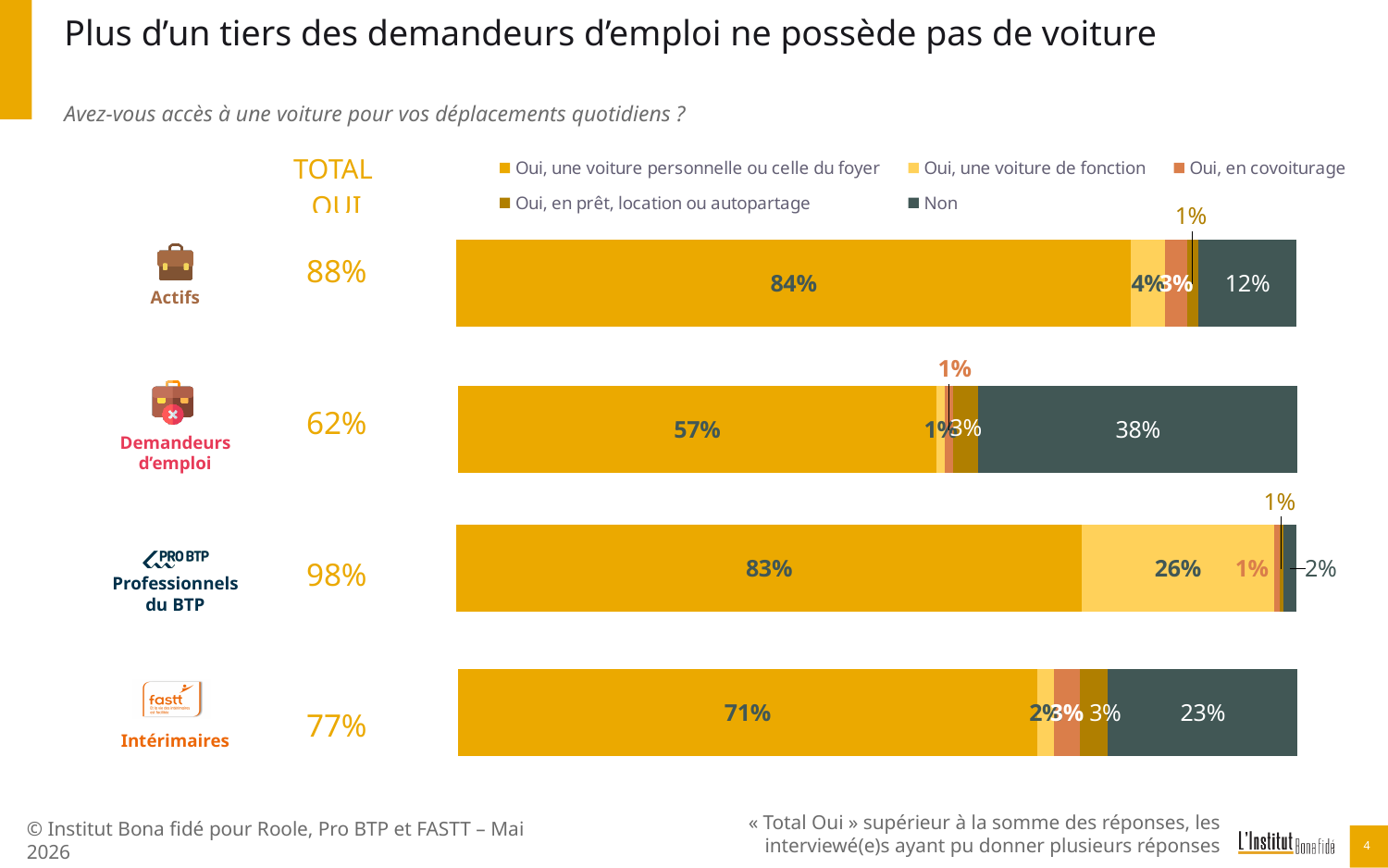
What is the value of "Non" for Intérimaires? 23% What is the value of "Oui, une voiture personnelle ou celle du foyer" for Actifs? 84% What is the difference between the "Non" value for Demandeurs d'emploi and the "Non" value for Actifs? 26 percentage points Which group has the highest "Non" value? Demandeurs d'emploi How many groups (categories) are plotted in the chart? 4 What is the TOTAL OUI value for Professionnels du BTP? 98% What is the value of "Non" for Demandeurs d'emploi? 38% How many series does the legend list? 5 Which group has the lowest TOTAL OUI value? Demandeurs d'emploi What is the value of "Oui, une voiture de fonction" for Professionnels du BTP? 26% Which is larger: the "Oui, une voiture personnelle ou celle du foyer" value for Intérimaires or for Demandeurs d'emploi? Intérimaires What kind of chart is shown on the slide? stacked bar chart